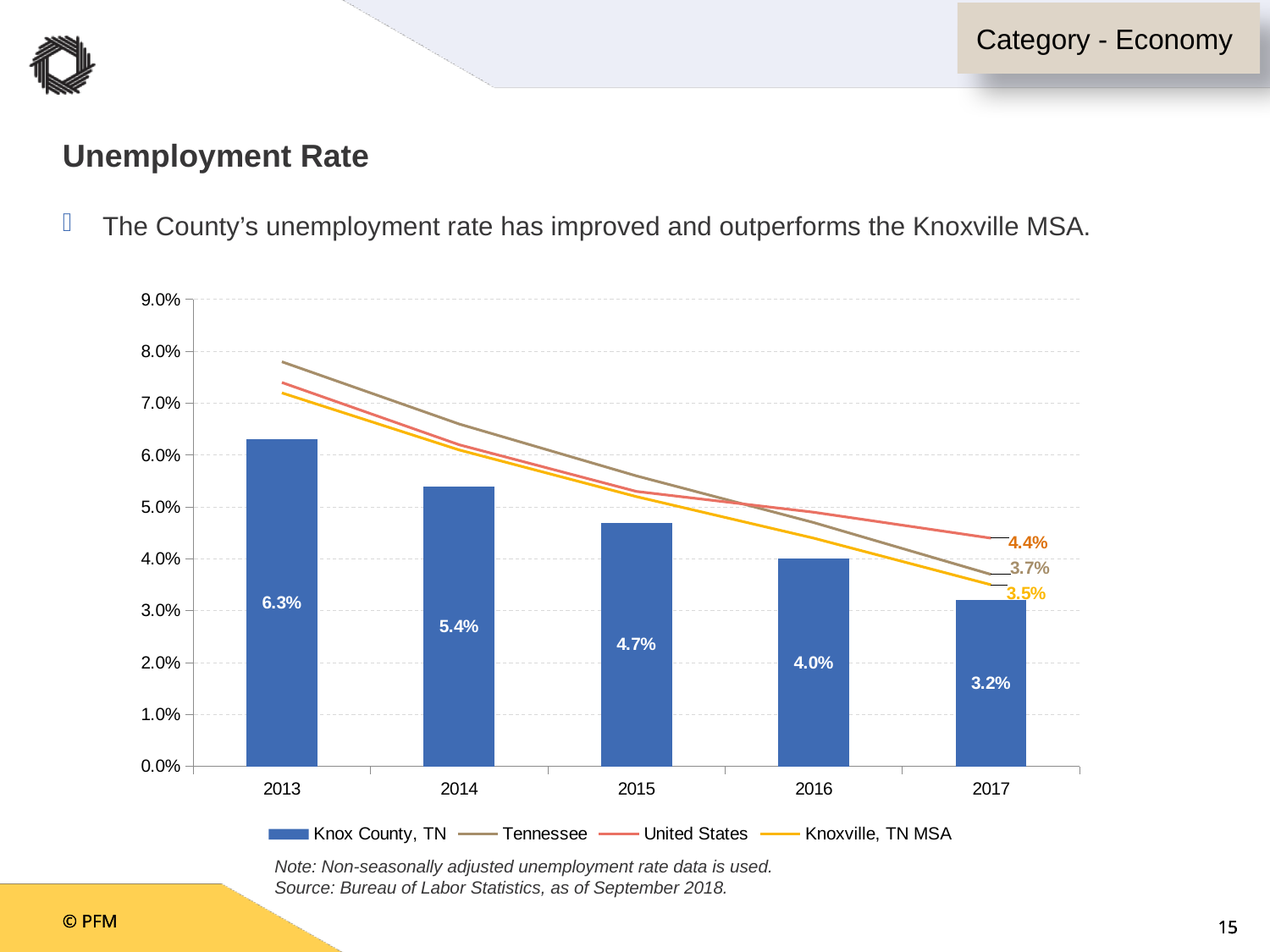
What is the unemployment rate for Knox County, TN in 2013? 6.3% Is the Tennessee unemployment rate in 2013 greater or less than 7.0%? greater In which year is the Knox County, TN unemployment rate lowest? 2017 What is the 2017 unemployment rate shown for the United States? 4.4% By how many percentage points did the Knox County, TN unemployment rate fall from 2013 to 2017? 3.1 percentage points Does the Knox County, TN unemployment rate rise or fall from 2013 to 2017? fall How many years are shown on the x axis? 5 In which year is the Knox County, TN unemployment rate highest? 2013 What is the 2017 unemployment rate shown for the Knoxville, TN MSA? 3.5% How many series does the legend list? 4 In 2017, which is higher: the United States rate or the Tennessee rate? United States What is the unemployment rate for Knox County, TN in 2017? 3.2%